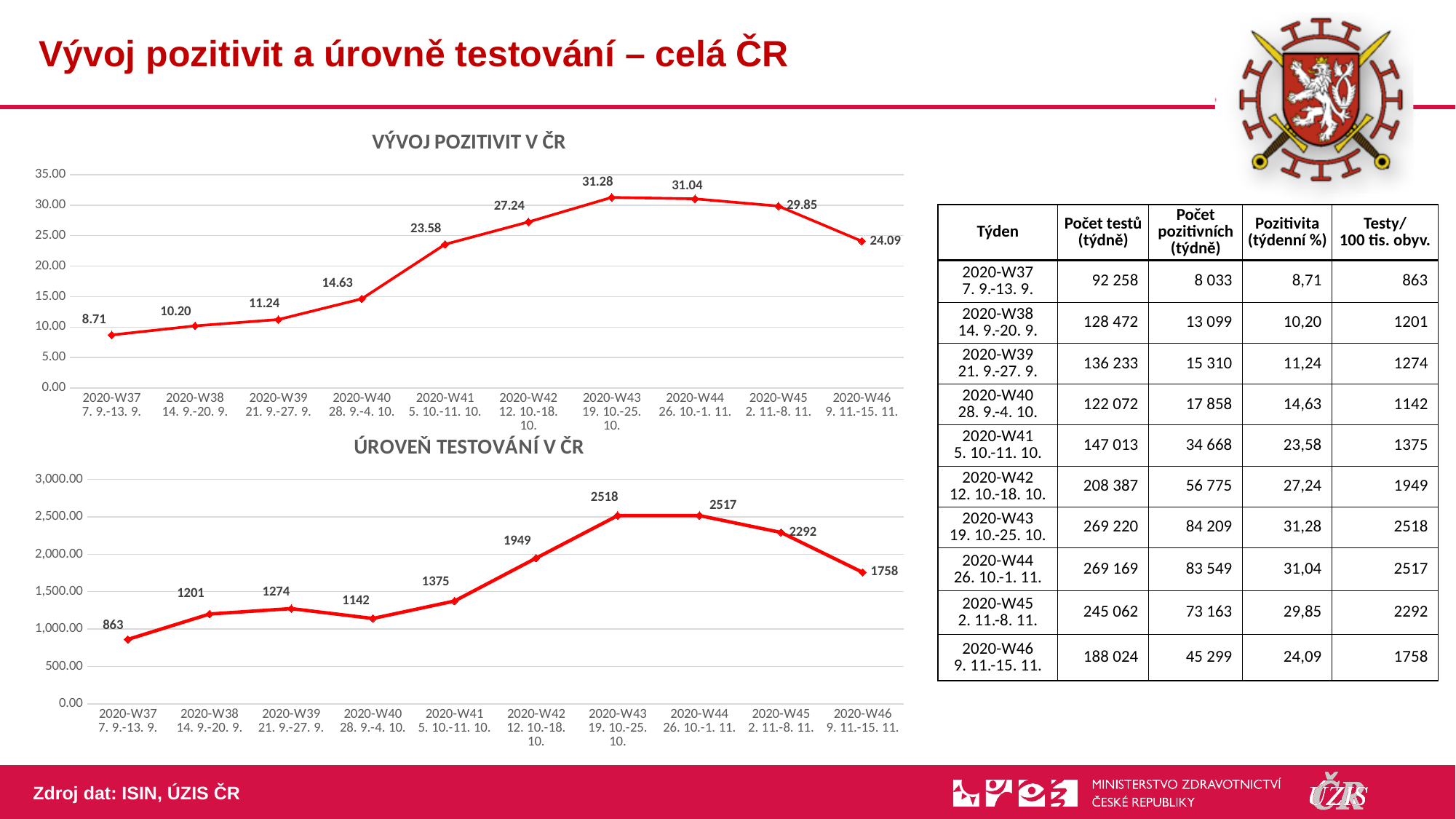
In the chart titled "ÚROVEŇ TESTOVÁNÍ V ČR", which is larger, the value for 2020-W39 or the value for 2020-W40? 2020-W39 In the chart titled "VÝVOJ POZITIVIT V ČR", is the value for 2020-W41 greater or less than 20.00? greater In the chart titled "VÝVOJ POZITIVIT V ČR", what is the difference between the values for 2020-W45 and 2020-W46? 5.76 In the chart titled "VÝVOJ POZITIVIT V ČR", do the values rise or fall from 2020-W37 to 2020-W43? rise What is the title of the top chart on the slide? VÝVOJ POZITIVIT V ČR In the chart titled "ÚROVEŇ TESTOVÁNÍ V ČR", which week has the highest value? 2020-W43 What kind of chart is the chart titled "ÚROVEŇ TESTOVÁNÍ V ČR"? line chart In the chart titled "ÚROVEŇ TESTOVÁNÍ V ČR", what is the difference between the values for 2020-W38 and 2020-W37? 338 In the chart titled "ÚROVEŇ TESTOVÁNÍ V ČR", what is the value for 2020-W42? 1949 In the chart titled "VÝVOJ POZITIVIT V ČR", which week has the lowest value? 2020-W37 In the chart titled "VÝVOJ POZITIVIT V ČR", how many weeks are plotted on the x axis? 10 In the chart titled "VÝVOJ POZITIVIT V ČR", what is the value for 2020-W43? 31.28